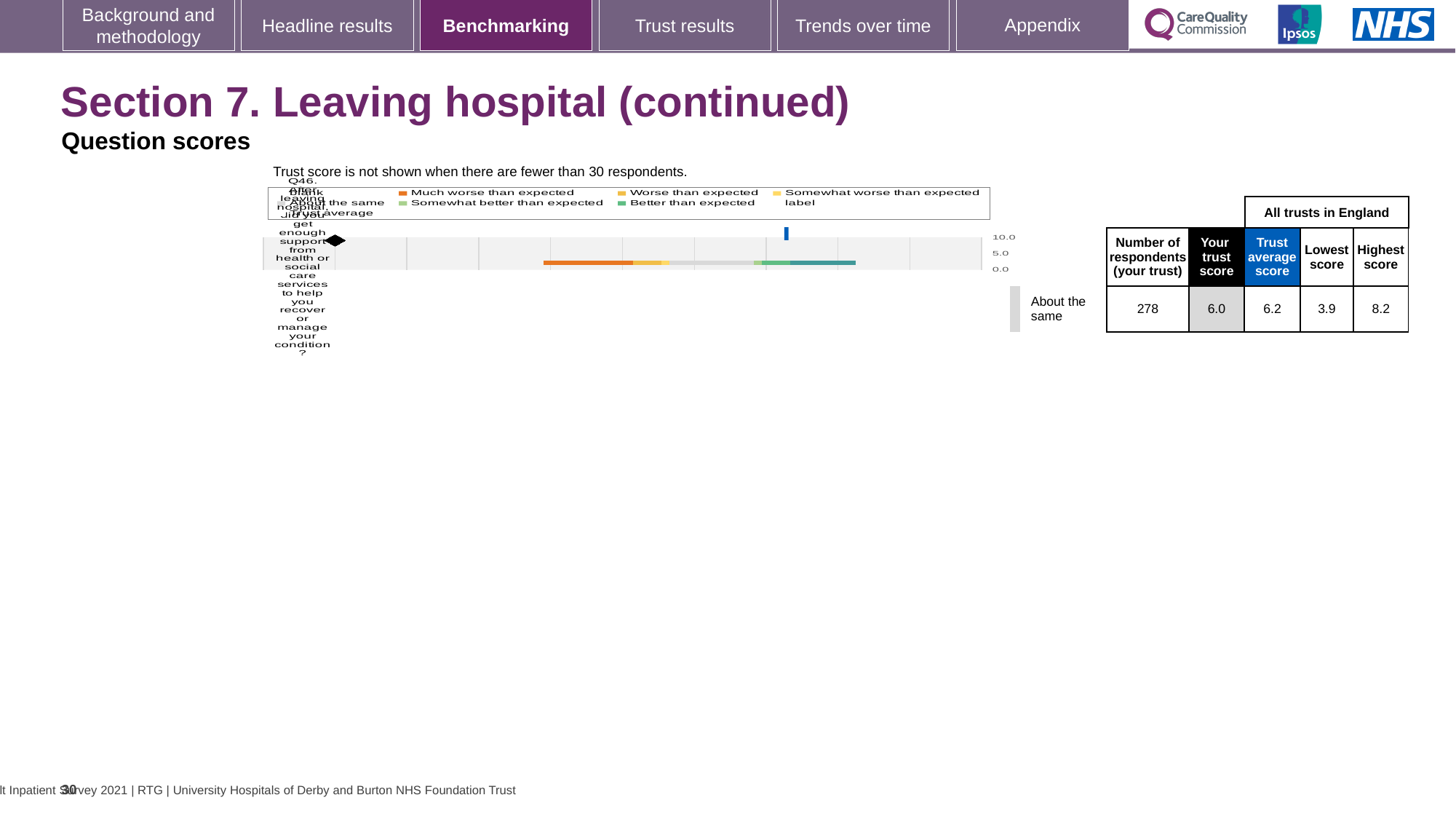
Is the trust's score for Q46 greater or less than 5.0? greater How many respondents from the trust answered Q46? 278 What is the difference between the highest and lowest scores for Q46 across all trusts in England? 4.3 What is the highest score for Q46 among all trusts in England? 8.2 How many questions are plotted on the chart? 1 Which is larger for Q46: the trust's score or the trust average score? Trust average score What is the trust average score for Q46 across all trusts in England? 6.2 What kind of chart is used to show the Q46 benchmarking result? bar chart Which benchmark category is the trust's Q46 score placed in? About the same What is the lowest score for Q46 among all trusts in England? 3.9 What is the highest value shown on the chart's score axis? 10.0 What is the trust's score for Q46? 6.0